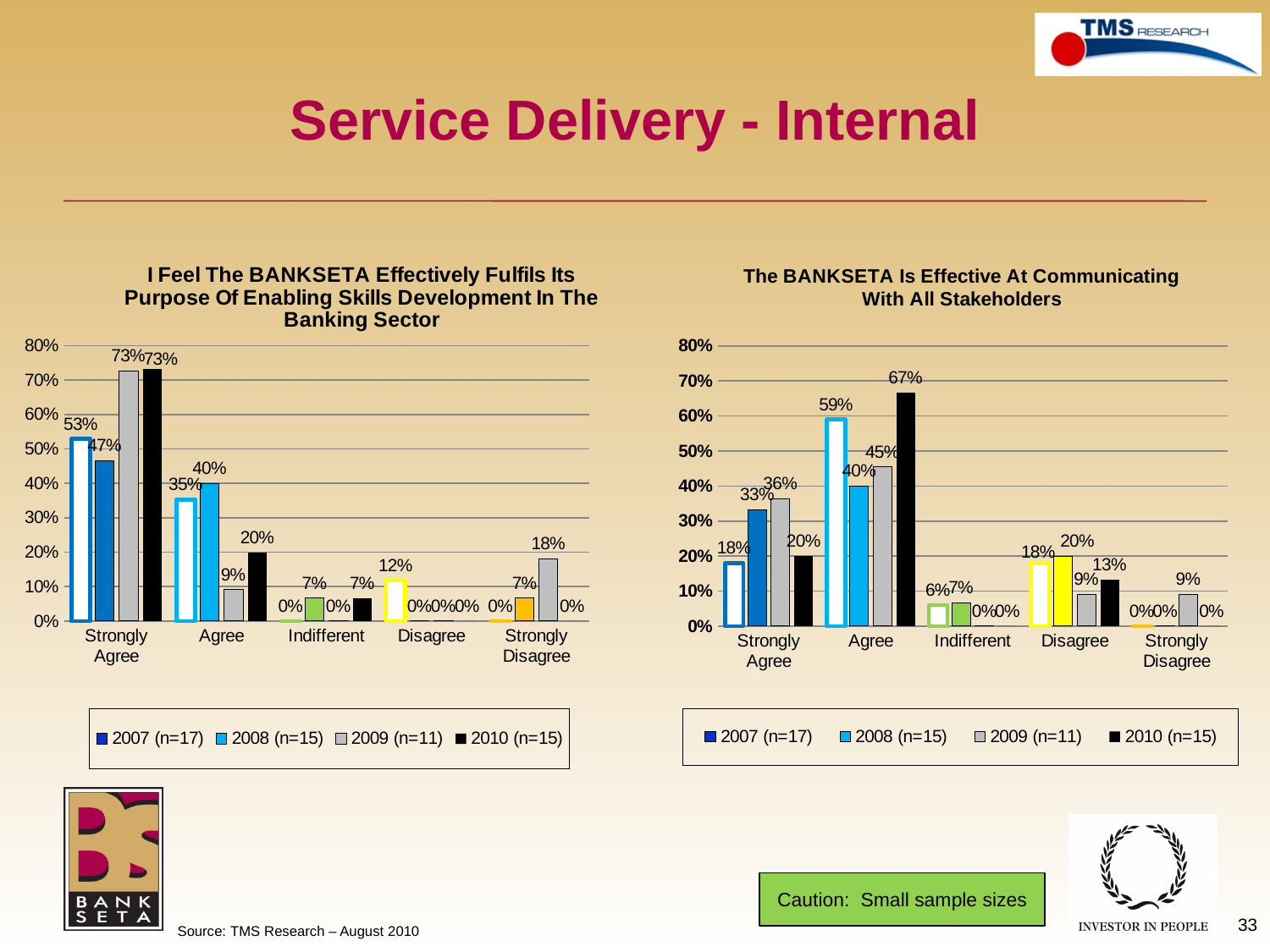
In the right chart, which is larger for Disagree: the 2009 (n=11) value or the 2010 (n=15) value? 2010 (n=15) In the left chart, what is the difference between the 2007 (n=17) and 2008 (n=15) values for Strongly Agree? 6% How many series does the legend of the right chart list? 4 In the left chart, what is the value for Agree in 2008 (n=15)? 40% In the right chart, what is the difference between the 2010 (n=15) and 2007 (n=17) values for Agree? 8% In the chart titled "I Feel The BANKSETA Effectively Fulfils Its Purpose Of Enabling Skills Development In The Banking Sector", what is the value for Strongly Agree in 2009 (n=11)? 73% What type of chart is the left chart? Bar chart In the left chart, what is the value for Strongly Disagree in 2009 (n=11)? 18% In the right chart, which year has the lowest value for Agree? 2008 (n=15) In the right chart, what is the value for Strongly Agree in 2008 (n=15)? 33% In the chart titled "The BANKSETA Is Effective At Communicating With All Stakeholders", what is the value for Agree in 2010 (n=15)? 67% In the left chart, which category has the highest value for 2007 (n=17)? Strongly Agree